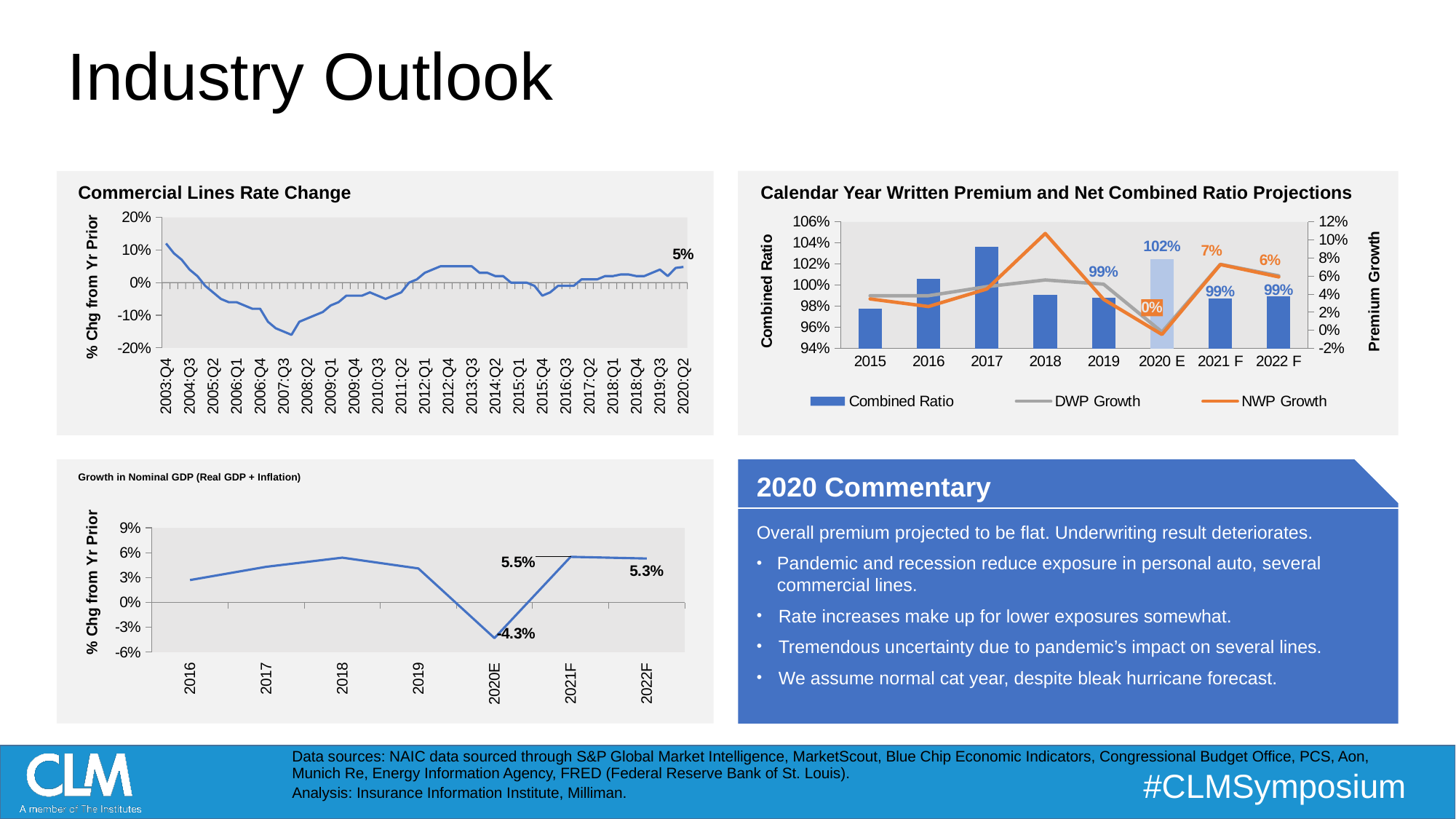
How many years are shown on the x axis of the Growth in Nominal GDP chart? 7 How many series does the legend of the Calendar Year Written Premium and Net Combined Ratio Projections chart list? 3 What kind of chart is the Growth in Nominal GDP chart? line chart On the Calendar Year Written Premium and Net Combined Ratio Projections chart, how much higher is NWP Growth in 2021 F than in 2022 F? 1% On the Growth in Nominal GDP chart, which is larger, the value for 2021F or the value for 2022F? 2021F On the Calendar Year Written Premium and Net Combined Ratio Projections chart, which year has the lowest Combined Ratio? 2015 On the Calendar Year Written Premium and Net Combined Ratio Projections chart, what is the Combined Ratio for 2020 E? 102% On the Growth in Nominal GDP chart, what is the value for 2020E? -4.3% On the Commercial Lines Rate Change chart, which quarter has the highest rate change? 2003:Q4 On the Commercial Lines Rate Change chart, is the value for 2007:Q3 greater or less than -10%? less On the Calendar Year Written Premium and Net Combined Ratio Projections chart, what is the NWP Growth for 2021 F? 7% On the Commercial Lines Rate Change chart, what is the value shown for 2020:Q2? 5%